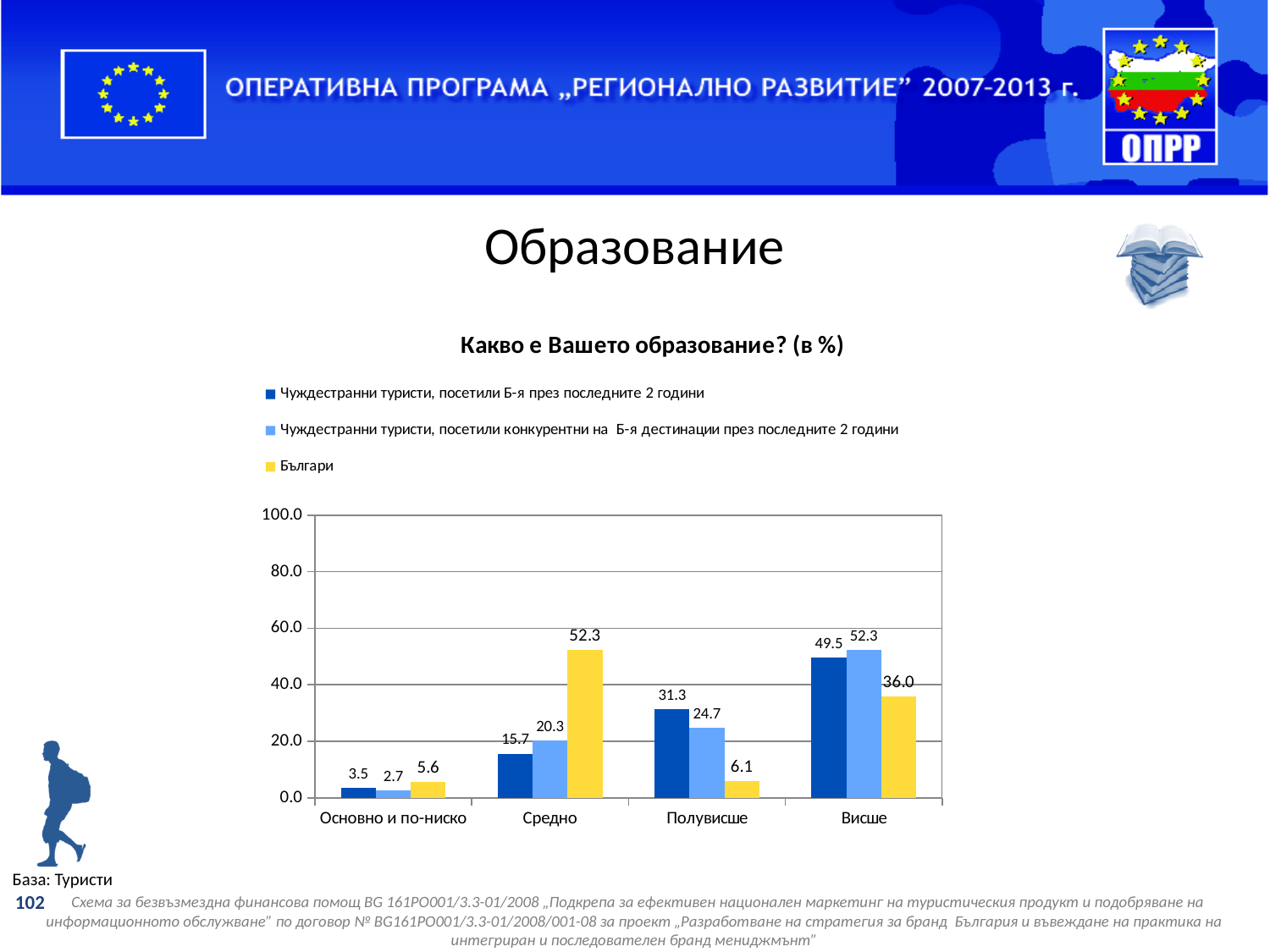
How many series does the legend list? 3 Which category has the lowest value for Чуждестранни туристи, посетили Б-я през последните 2 години? Основно и по-ниско What kind of chart is shown on the slide? Bar chart In the Полувисше category, which series has the larger value: Чуждестранни туристи, посетили Б-я през последните 2 години or Българи? Чуждестранни туристи, посетили Б-я през последните 2 години How many categories are shown on the x axis? 4 What is the difference between the Българи value and the Чуждестранни туристи, посетили Б-я през последните 2 години value in the Висше category? 13.5 What is the title of the chart? Какво е Вашето образование? (в %) What is the value for Чуждестранни туристи, посетили конкурентни на Б-я дестинации през последните 2 години in the Полувисше category? 24.7 What is the value for Чуждестранни туристи, посетили Б-я през последните 2 години in the Висше category? 49.5 Which category has the highest value for Българи? Средно What is the value for Българи in the Основно и по-ниско category? 5.6 What is the value for Българи in the Средно category? 52.3